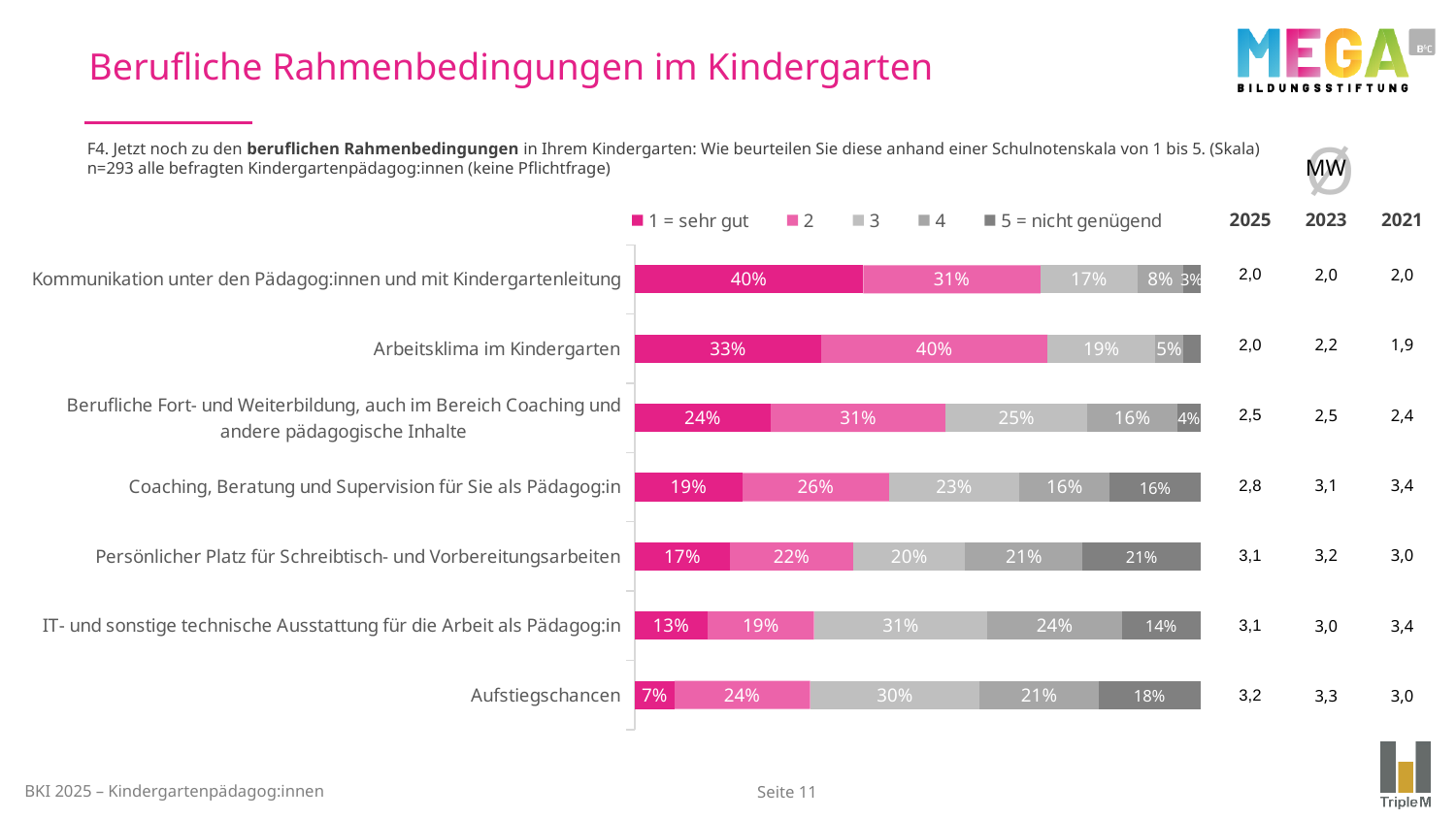
What share of respondents rated 'Aufstiegschancen' with '5 = nicht genügend'? 18% What is the value of the '3' segment for 'IT- und sonstige technische Ausstattung für die Arbeit als Pädagog:in'? 31% What kind of chart is shown on the slide? Stacked bar chart Which category has the lowest share of '1 = sehr gut' ratings? Aufstiegschancen What is the difference in percentage points between the '1 = sehr gut' share for 'Kommunikation unter den Pädagog:innen und mit Kindergartenleitung' and for 'Aufstiegschancen'? 33 percentage points What is the value of the '4' segment for 'Persönlicher Platz für Schreibtisch- und Vorbereitungsarbeiten'? 21% What share of respondents rated 'Kommunikation unter den Pädagog:innen und mit Kindergartenleitung' with '1 = sehr gut'? 40% How many series does the legend list? 5 Which category has the highest share of '1 = sehr gut' ratings? Kommunikation unter den Pädagog:innen und mit Kindergartenleitung What is the total of the printed segment values for the 'Aufstiegschancen' bar? 100% Which has the larger '2' segment: 'Arbeitsklima im Kindergarten' or 'Coaching, Beratung und Supervision für Sie als Pädagog:in'? Arbeitsklima im Kindergarten How many categories (rows) does the chart show? 7